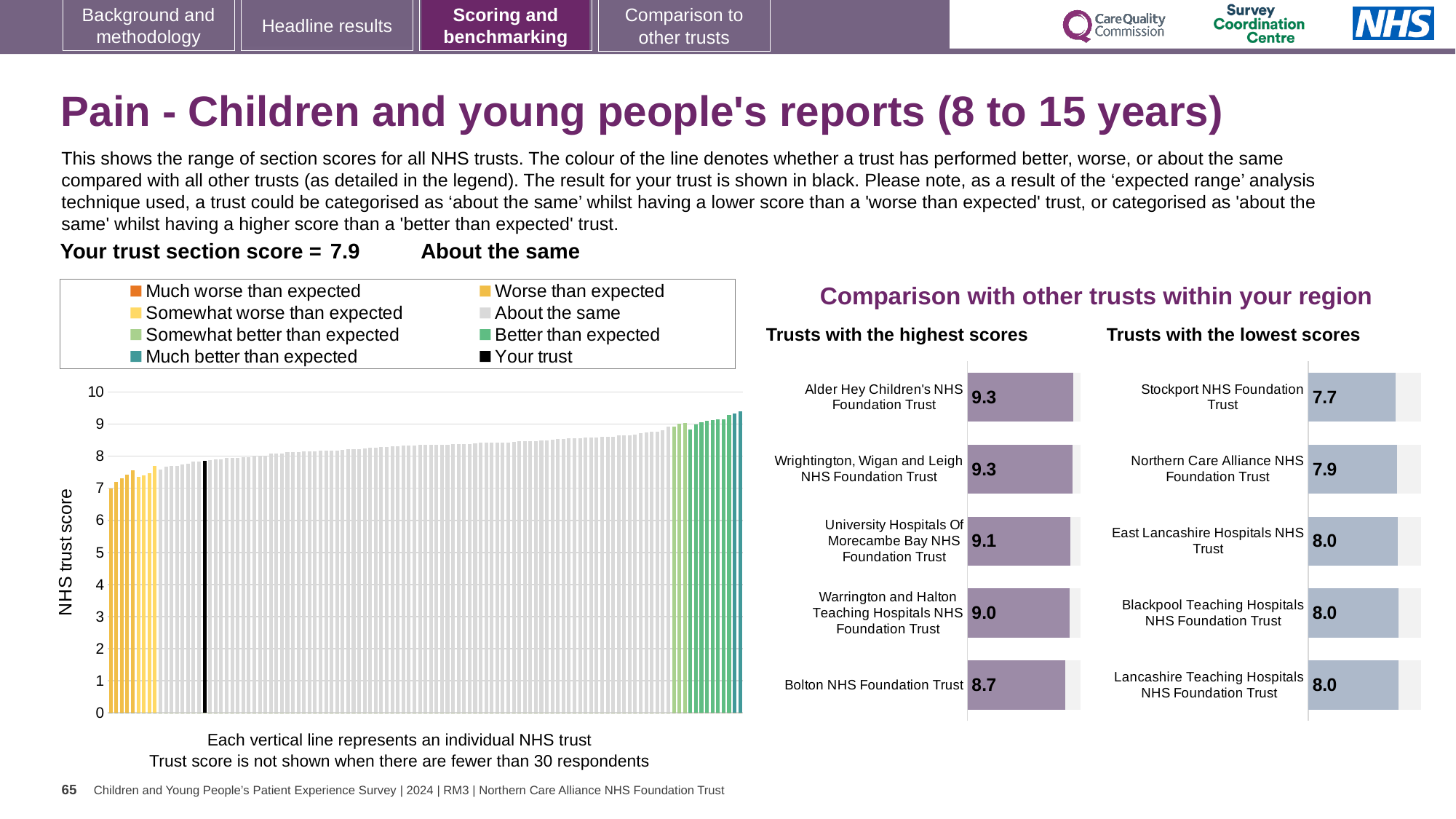
What kind of chart is the large chart on the left showing NHS trust scores? Bar chart In the 'Trusts with the lowest scores' chart, what is the score for Stockport NHS Foundation Trust? 7.7 In the 'Trusts with the highest scores' chart, what is the score for Bolton NHS Foundation Trust? 8.7 In the large chart on the left, do the trust scores rise or fall from left to right? Rise How many trusts are shown in the 'Trusts with the highest scores' chart? 5 In the 'Trusts with the highest scores' chart, which trust has the lowest score? Bolton NHS Foundation Trust In the 'Trusts with the lowest scores' chart, which has the higher score: Stockport NHS Foundation Trust or Northern Care Alliance NHS Foundation Trust? Northern Care Alliance NHS Foundation Trust In the 'Trusts with the lowest scores' chart, which trust has the lowest score? Stockport NHS Foundation Trust In the 'Trusts with the lowest scores' chart, what is the difference between the scores of Northern Care Alliance NHS Foundation Trust and Stockport NHS Foundation Trust? 0.2 How many entries does the legend above the large chart on the left list? 8 In the 'Trusts with the highest scores' chart, what is the score for Alder Hey Children's NHS Foundation Trust? 9.3 In the 'Trusts with the highest scores' chart, what is the difference between the scores of Alder Hey Children's NHS Foundation Trust and Bolton NHS Foundation Trust? 0.6